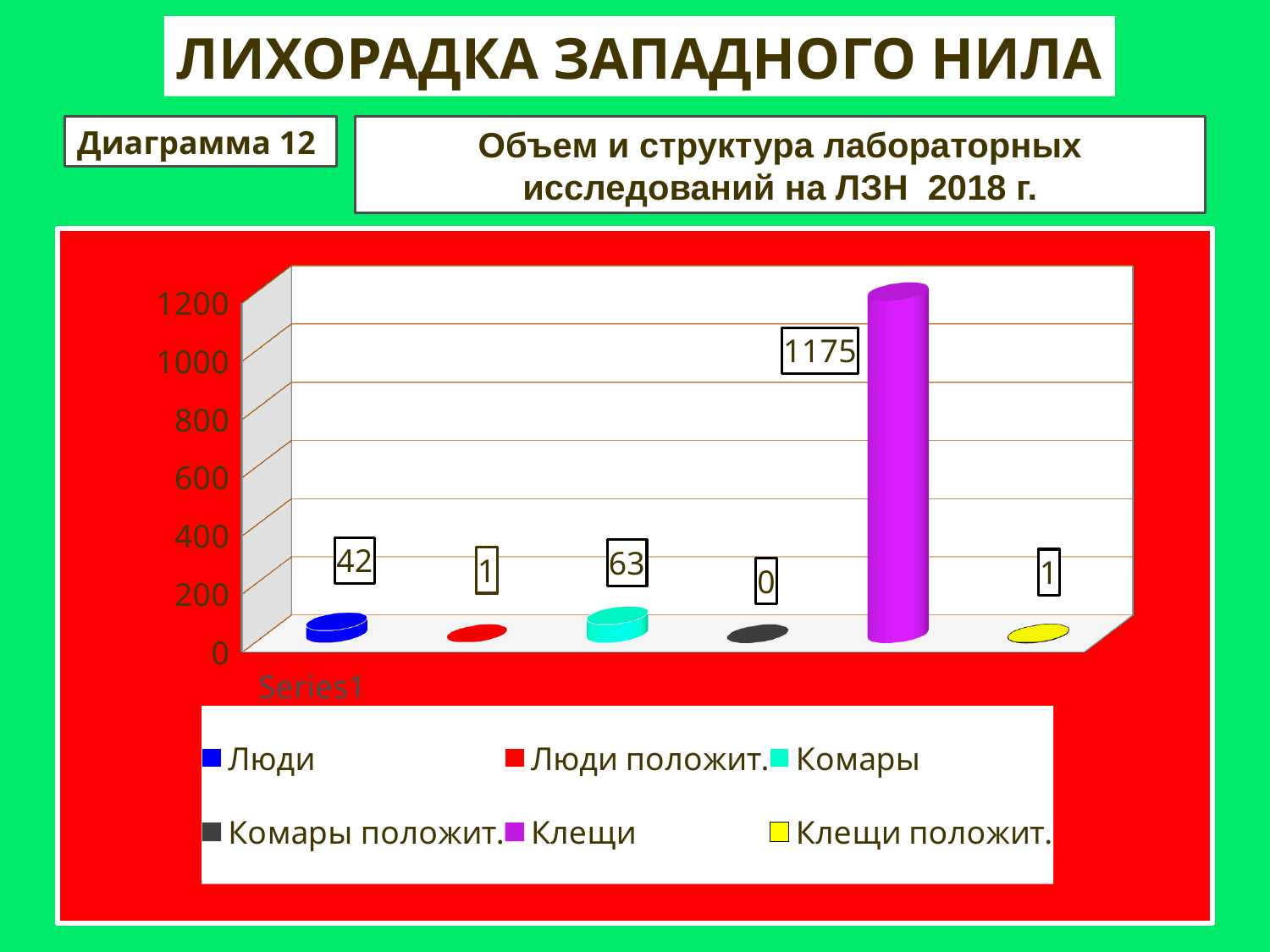
Which is larger, the value for Люди or the value for Комары? Комары What kind of chart is shown on the slide? bar chart What is the value for Комары положит.? 0 How many series does the legend list? 6 What is the difference between the values for Клещи and Комары? 1112 Which series has the highest value? Клещи What is the difference between the values for Комары and Люди? 21 Is the value for Клещи greater or less than 1000? greater What is the value for Клещи? 1175 What is the value for Комары? 63 What is the value for Люди? 42 Which series has the lowest value? Комары положит.